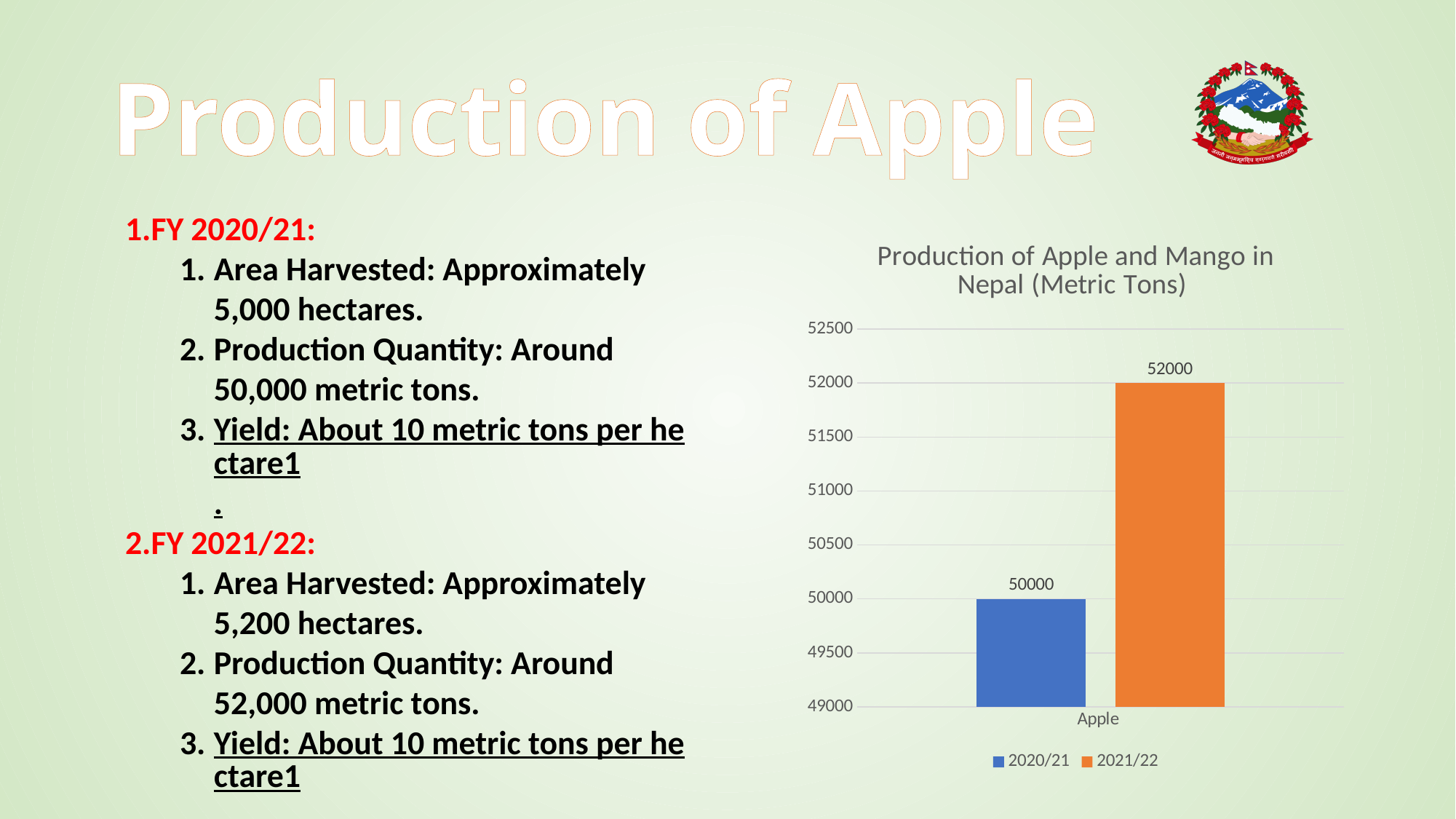
Which series has the lowest value in the chart? 2020/21 What kind of chart is shown on the slide? Bar chart Is the value for 2021/22 greater or less than 51000? greater What is the difference between the 2021/22 and 2020/21 values in the chart? 2000 What is the production value for 2021/22 in the chart? 52000 What is the production value for 2020/21 in the chart? 50000 Is the value for 2020/21 greater or less than 50500? less What colour is the bar for the 2021/22 series? Orange Which series has the higher value in the chart, 2020/21 or 2021/22? 2021/22 What is the title of the chart? Production of Apple and Mango in Nepal (Metric Tons) How many categories are shown on the x axis of the chart? 1 How many series does the chart legend list? 2